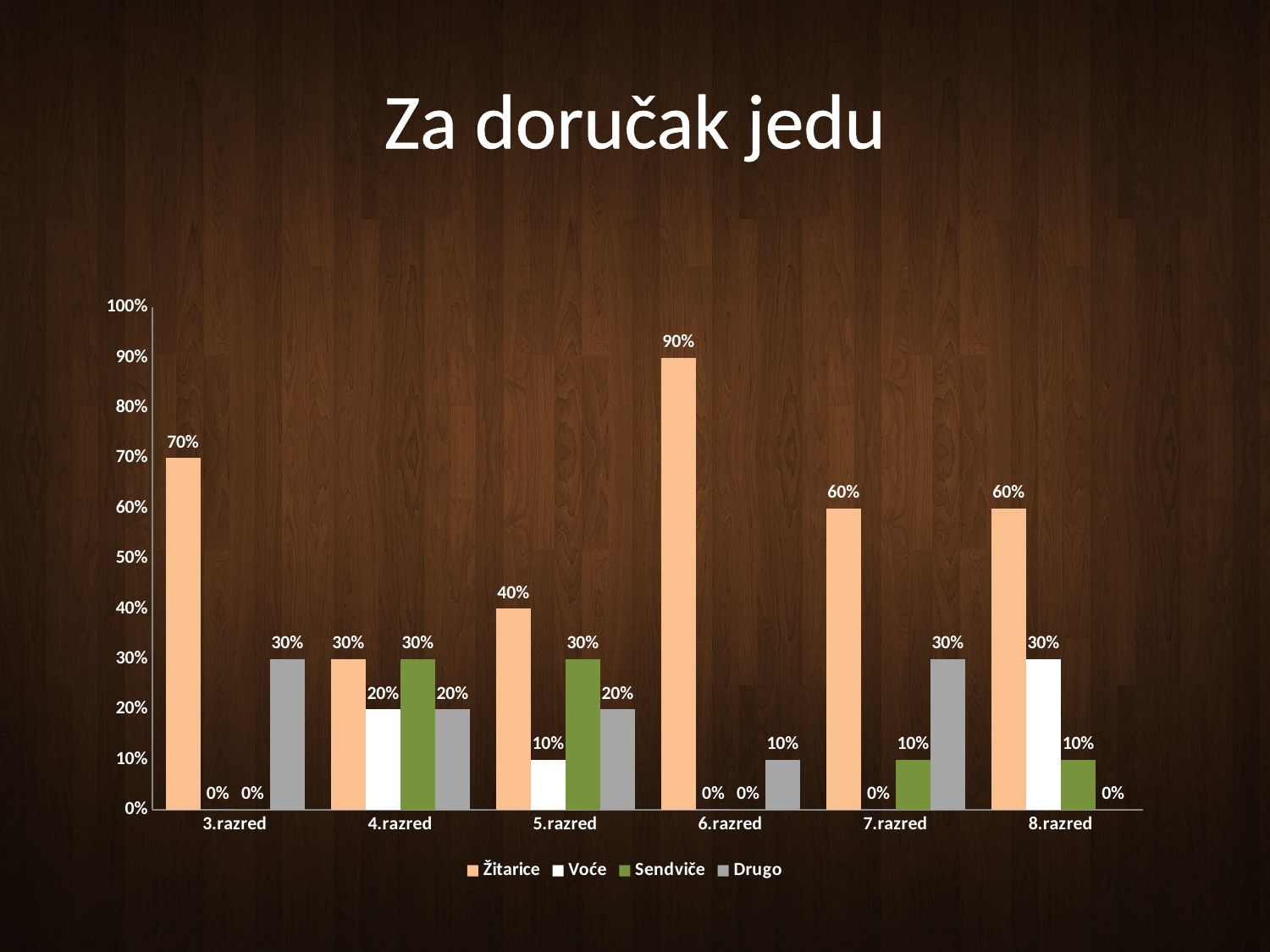
Which series is shown in green in the legend? Sendviče What kind of chart is shown on the slide? bar chart What is the value for Voće in 8.razred? 30% What is the title of the chart? Za doručak jedu How many categories (razred groups) are shown on the x axis? 6 What is the value for Žitarice in 6.razred? 90% What is the difference between the Žitarice values for 6.razred and 3.razred? 20% Which is larger in 5.razred: the value for Sendviče or the value for Voće? Sendviče Which category has the highest value for Žitarice? 6.razred Which category has the lowest value for Žitarice? 4.razred How many series does the legend list? 4 What is the value for Drugo in 3.razred? 30%